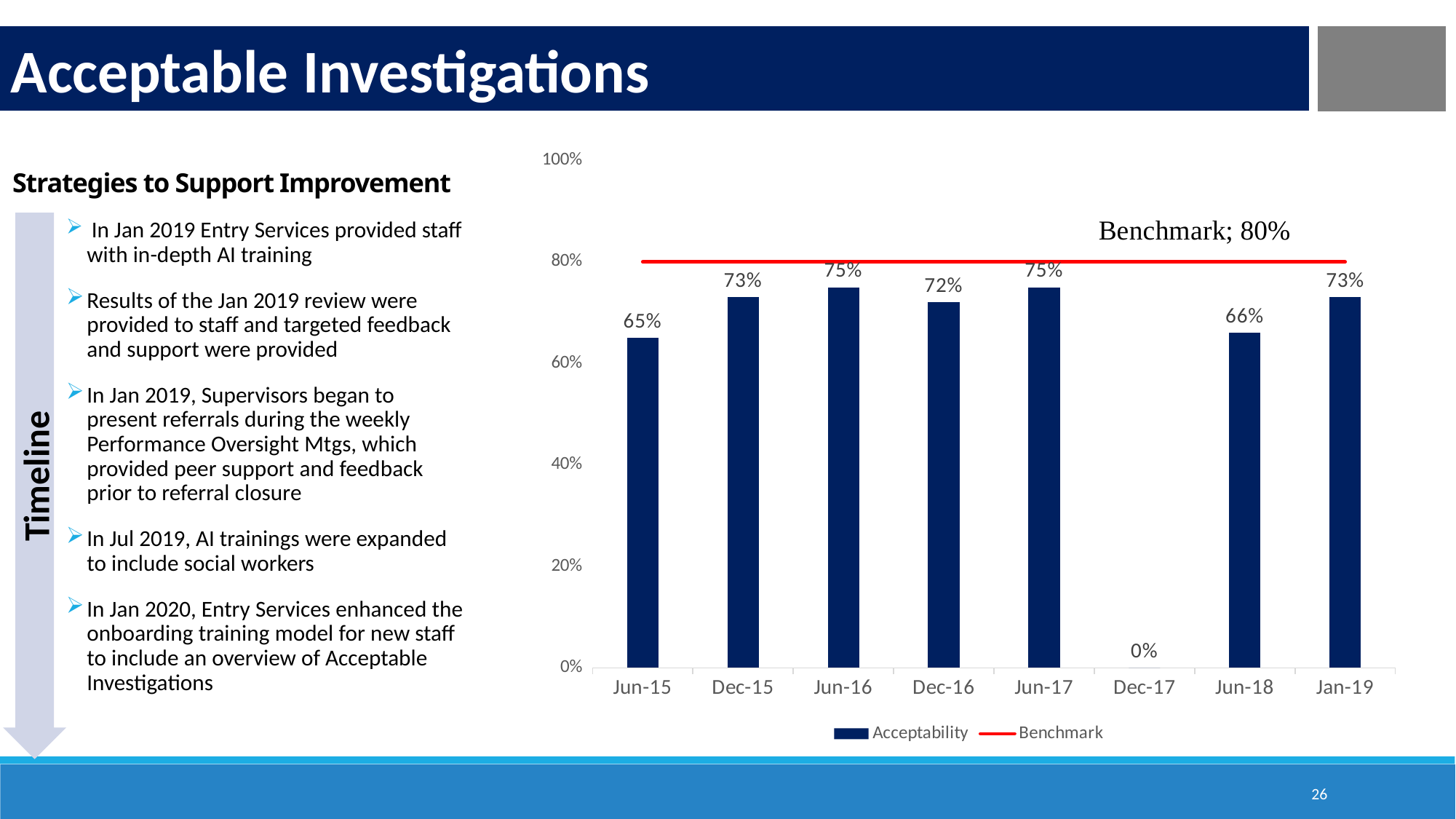
How many series does the legend list? 2 What is the difference between the Acceptability values for Jan-19 and Jun-18? 7% Is the Acceptability value for Jun-17 greater or less than the 80% benchmark? less Which is larger, the Acceptability value for Dec-15 or for Jun-15? Dec-15 What is the Acceptability value for Dec-16? 72% What is the Acceptability value for Jun-18? 66% How many periods are shown on the x axis? 8 What is the Acceptability value for Jun-15? 65% What kind of chart is used to show the Acceptability values? bar chart What is the Benchmark value shown on the chart? 80% Which period has the lowest Acceptability value? Dec-17 What colour is the Benchmark line? red